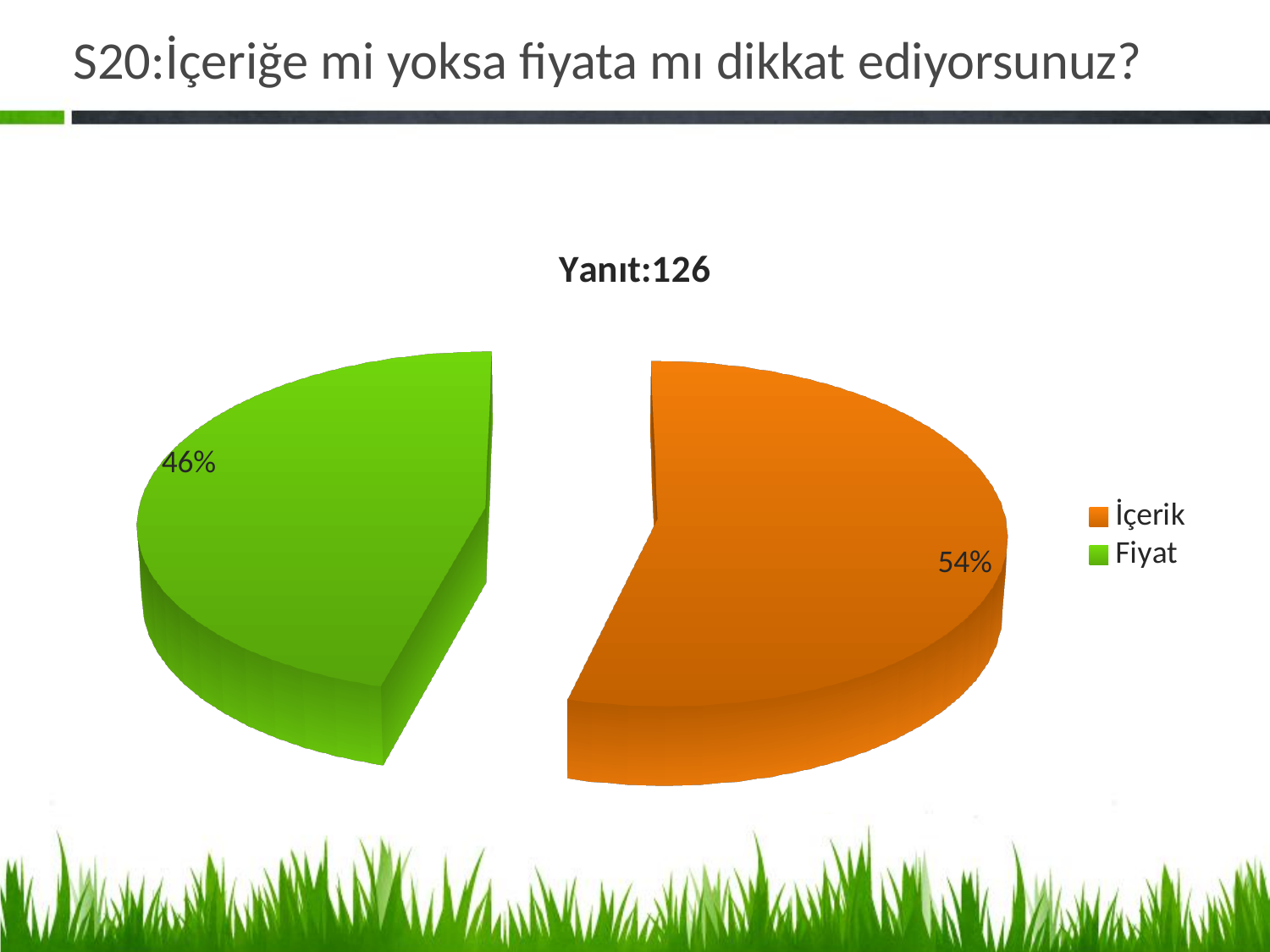
How many slices does the pie chart have? 2 What colour is the Fiyat slice? Green What kind of chart is shown on the slide? Pie chart Which category has the largest slice of the pie? İçerik What share of the pie does İçerik have? 54% What is the title of the chart? Yanıt:126 Which is larger, the İçerik slice or the Fiyat slice? İçerik What is the difference in percentage points between the İçerik and Fiyat slices? 8 Which category has the smallest slice of the pie? Fiyat What share of the pie does Fiyat have? 46% Is the share for İçerik greater or less than 50%? greater